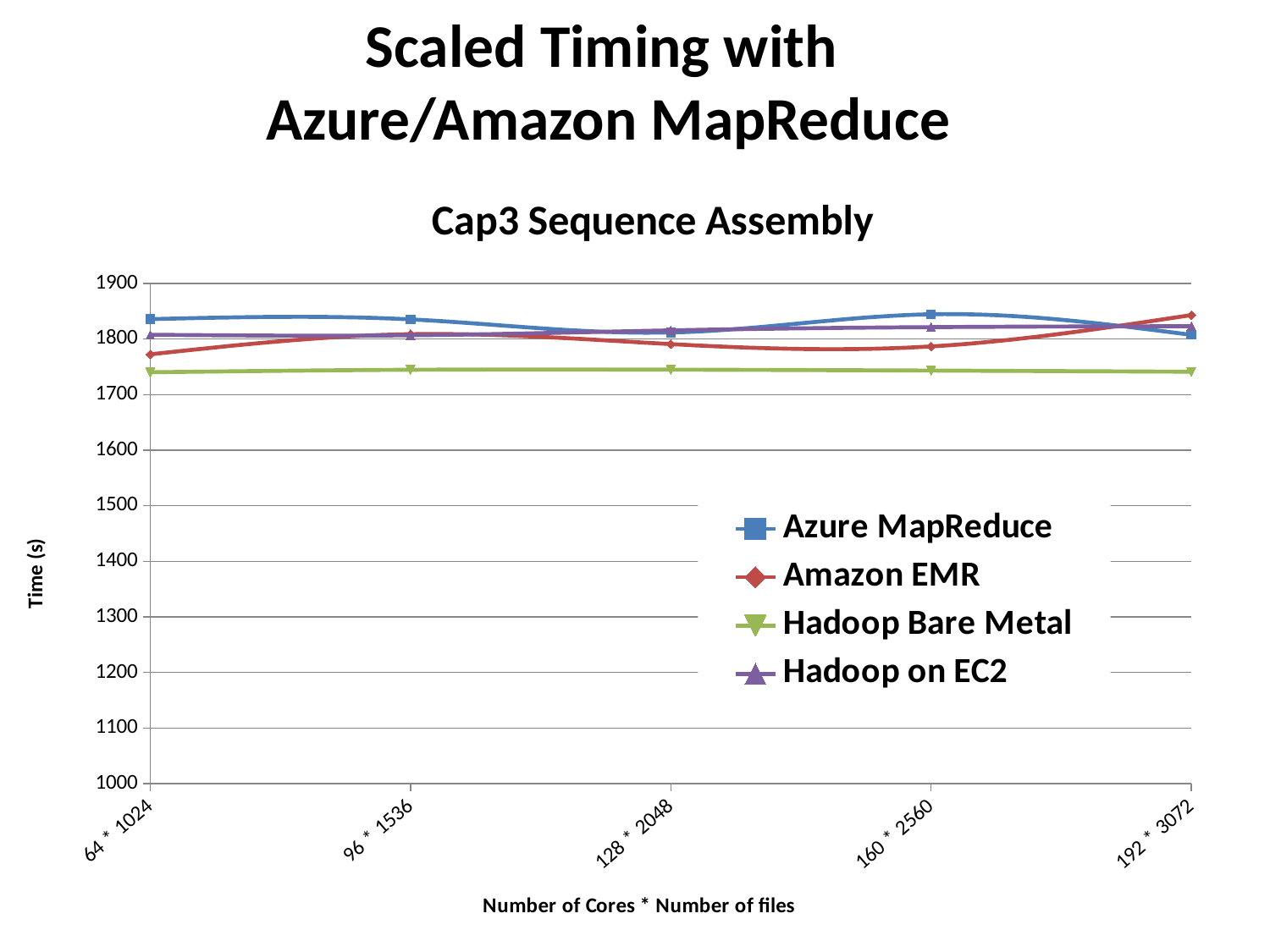
Is the value for Azure MapReduce at 64 * 1024 greater or less than 1800? greater At 64 * 1024, which is higher: Azure MapReduce or Amazon EMR? Azure MapReduce What is the title of the chart? Cap3 Sequence Assembly Is the value for Amazon EMR at 160 * 2560 greater or less than 1800? less What kind of chart is shown on the slide? line chart Which series has the lowest time at 64 * 1024? Hadoop Bare Metal How many categories are shown along the x axis? 5 What is the label of the y axis? Time (s) Is the value for Hadoop Bare Metal at 192 * 3072 greater or less than 1700? greater How many series does the legend list? 4 At 192 * 3072, which is higher: Amazon EMR or Azure MapReduce? Amazon EMR